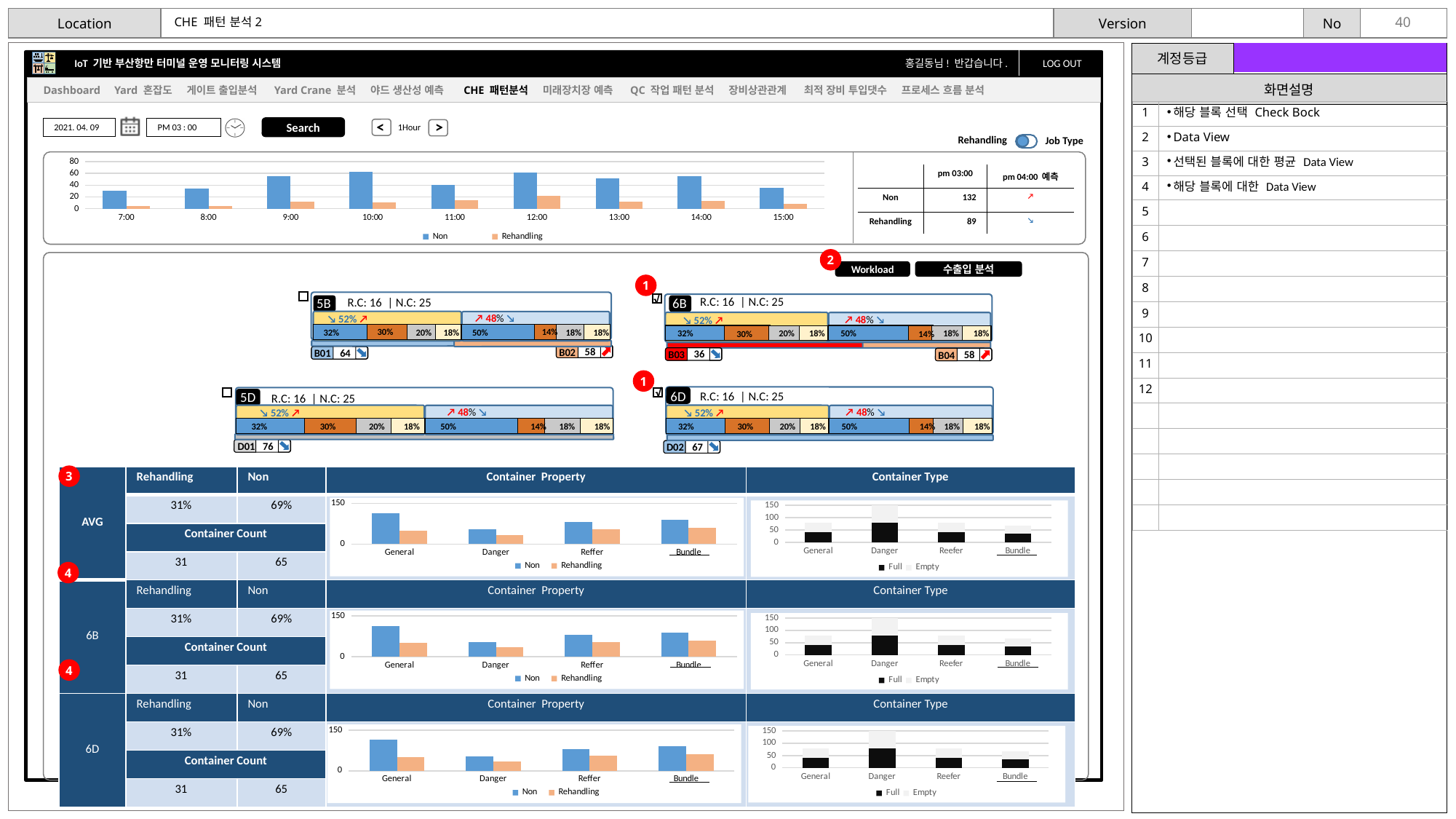
What kind of chart is the top hourly chart? bar chart In the AVG row's Container Property chart, which category has the highest Non value? General In the top hourly chart, at which hour is the Rehandling value highest? 12:00 In the top hourly chart, which is larger, the Non value at 7:00 or the Non value at 9:00? 9:00 In the top hourly chart, is the Non value at 10:00 greater or less than 40? greater In the top hourly chart, how many series does the legend list? 2 In the 6B row's Container Property chart, is the Non value for General greater or less than 150? less In the top hourly chart, how many time categories are shown on the x axis? 9 In the top hourly chart, what are the two legend entries? Non, Rehandling In the AVG row's Container Type chart, how many categories are shown on the x axis? 4 In the top hourly chart, is the Rehandling value at 7:00 greater or less than 20? less In the AVG row's Container Type chart, which category has the highest Full value? Danger